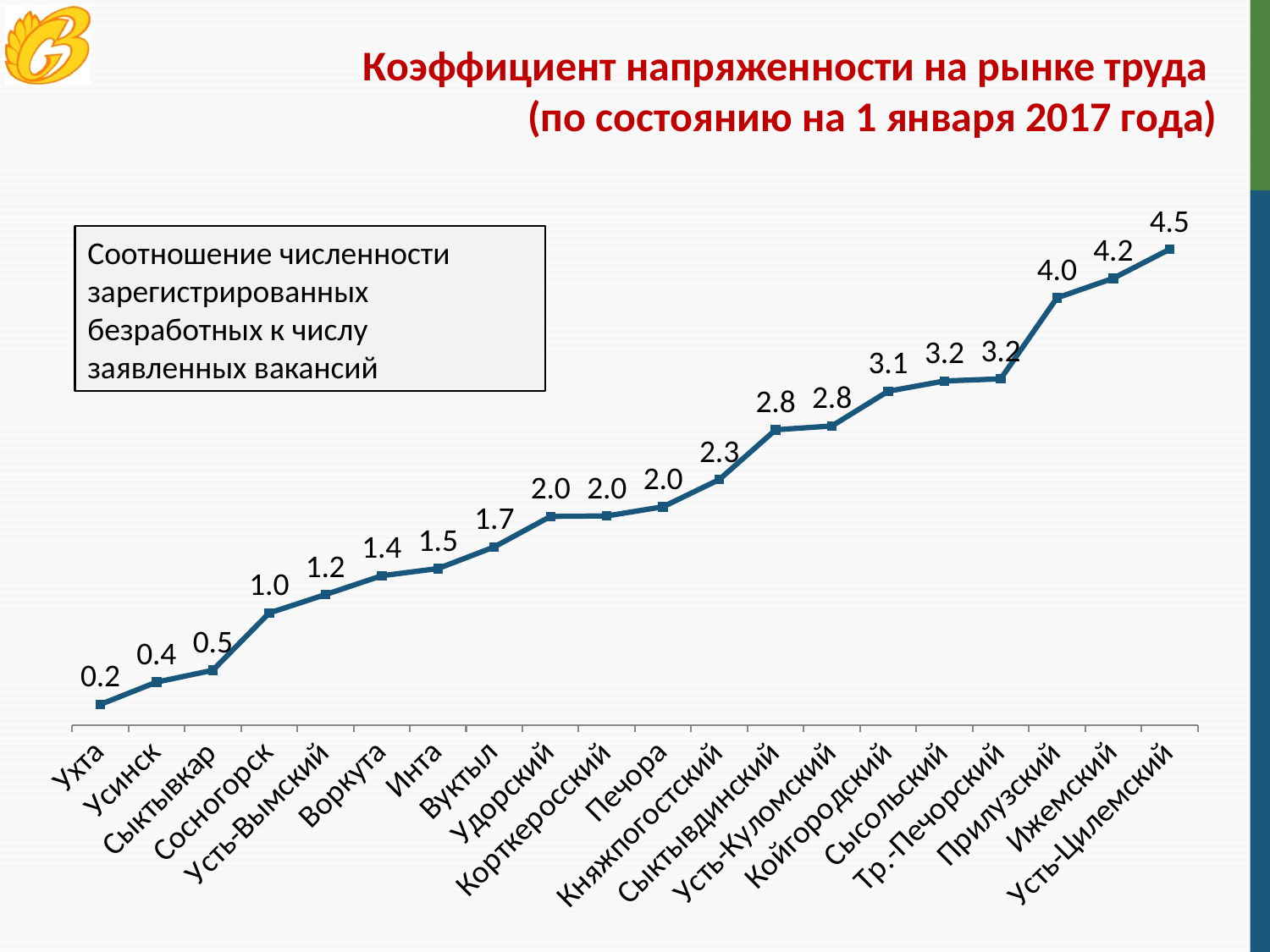
What is the value for Прилузский? 4.0 What is the value for Княжпогостский? 2.3 What is the value for Ухта? 0.2 Which category has the lowest value? Ухта Which category has the highest value? Усть-Цилемский What is the difference between the values for Ижемский and Сосногорск? 3.2 What is the value for Воркута? 1.4 Which is larger, the value for Инта or the value for Печора? Печора Do the values rise or fall from left to right along the x axis? Rise What kind of chart is shown on the slide? Line chart What is the difference between the values for Усть-Цилемский and Ухта? 4.3 How many categories are plotted on the chart? 20